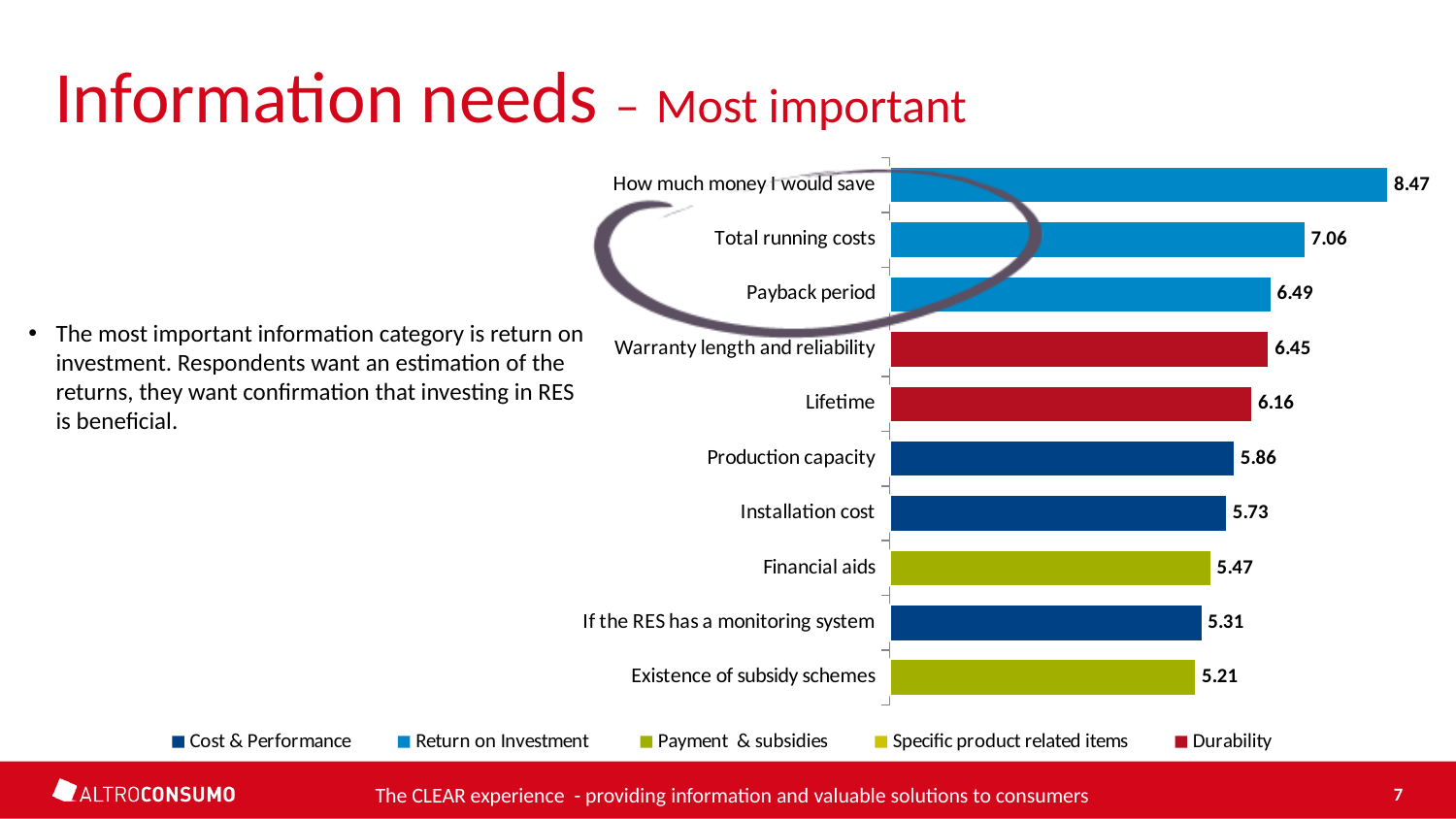
What is the value for "Payback period"? 6.49 What kind of chart is shown on the slide? Bar chart What is the value for "Existence of subsidy schemes"? 5.21 Which is larger, the value for "Lifetime" or the value for "Production capacity"? Lifetime How many series does the legend list? 5 Which legend series do the bars for "Warranty length and reliability" and "Lifetime" belong to? Durability Which category has the lowest value? Existence of subsidy schemes Which category has the highest value? How much money I would save What is the difference between the values for "Financial aids" and "Existence of subsidy schemes"? 0.26 How many categories are shown in the chart? 10 What is the value for "How much money I would save"? 8.47 What is the difference between the values for "How much money I would save" and "Total running costs"? 1.41